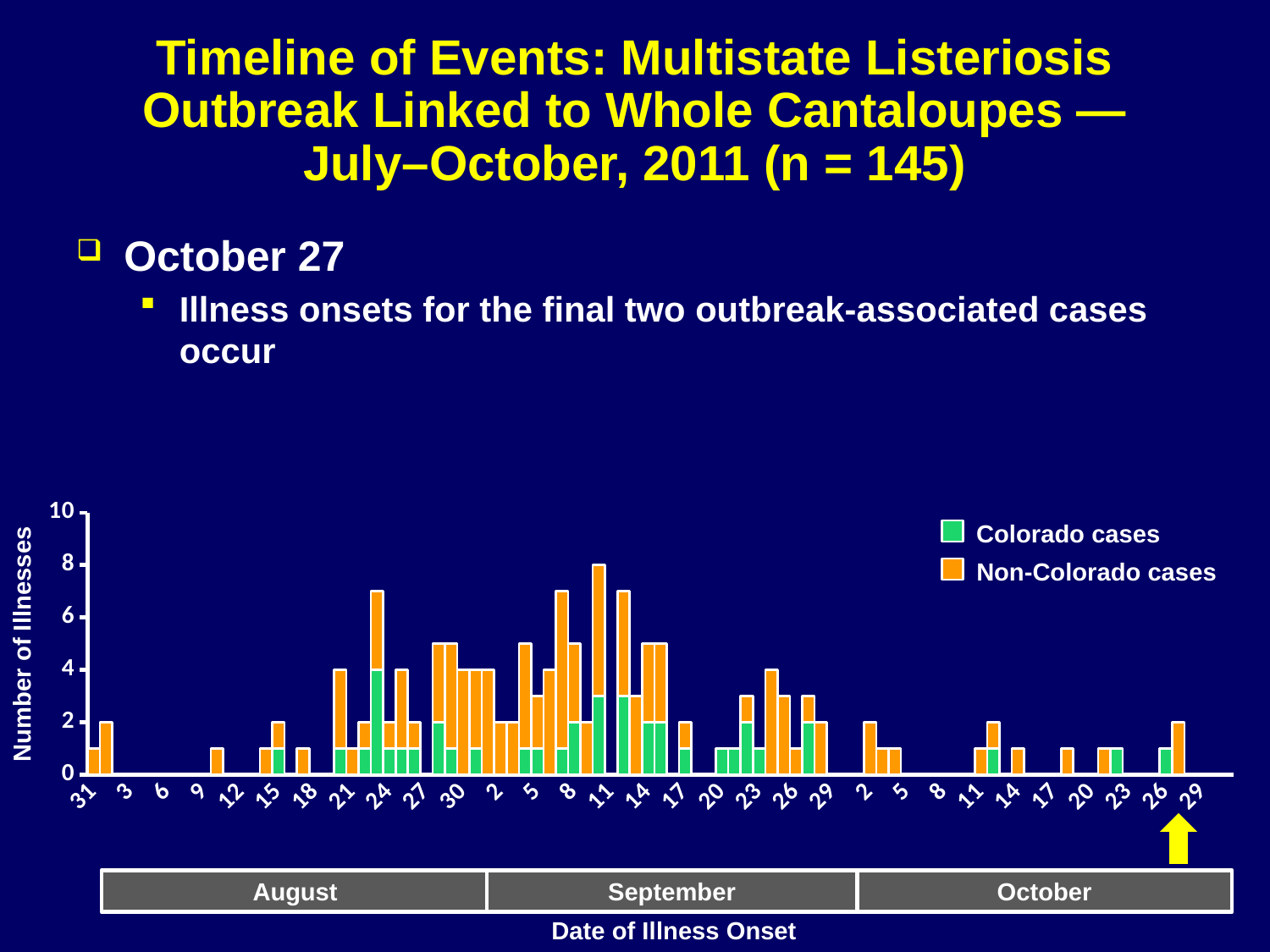
What kind of chart is shown on the slide? Stacked bar chart What is the title of the chart's vertical axis? Number of Illnesses What are the two series named in the chart's legend? Colorado cases and Non-Colorado cases How many months are labelled along the x axis of the chart? 3 Is the number of illnesses on October 2 greater or less than 4? less How many series does the chart's legend list? 2